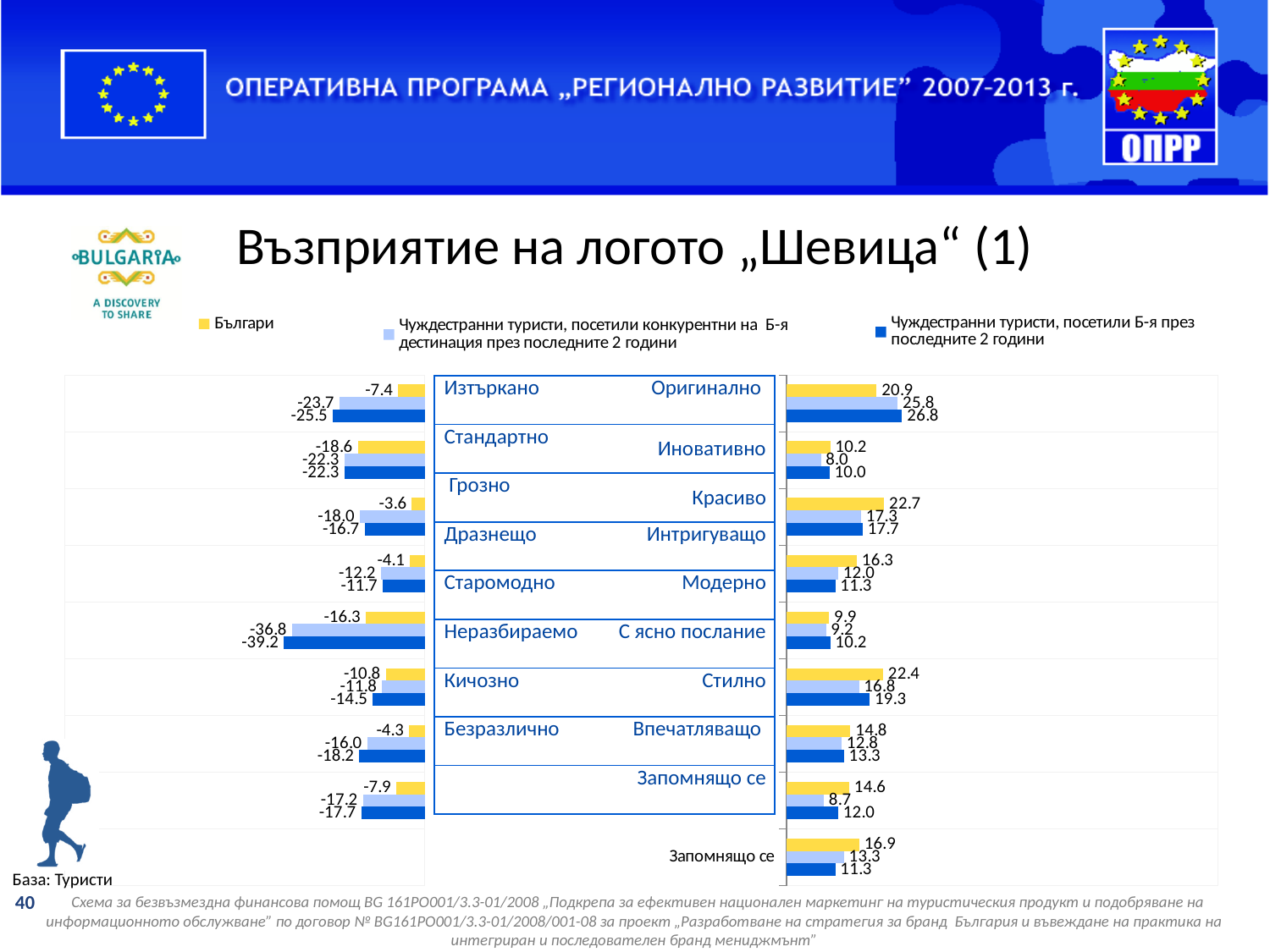
What is the value for Българи for the attribute Изтъркано? -7.4 What is the highest value shown on the right (positive) side of the chart? 26.8 What is the value for Чуждестранни туристи, посетили Б-я през последните 2 години for the attribute Оригинално? 26.8 What is the lowest value shown on the left (negative) side of the chart? -39.2 What is the value for Чуждестранни туристи, посетили конкурентни на Б-я дестинация for the attribute Изтъркано? -23.7 For Оригинално, what is the difference between the value for Чуждестранни туристи, посетили Б-я през последните 2 години and the value for Българи? 5.9 What is the value for Българи for the attribute Оригинално? 20.9 What kind of chart is shown on the slide? bar chart What colour represents the series Българи in the chart? yellow How many series does the legend list? 3 In the bottom row labelled Запомнящо се, what is the value for Българи? 16.9 For Оригинално, which is larger: the value for Българи or the value for Чуждестранни туристи, посетили конкурентни на Б-я дестинация? Чуждестранни туристи, посетили конкурентни на Б-я дестинация